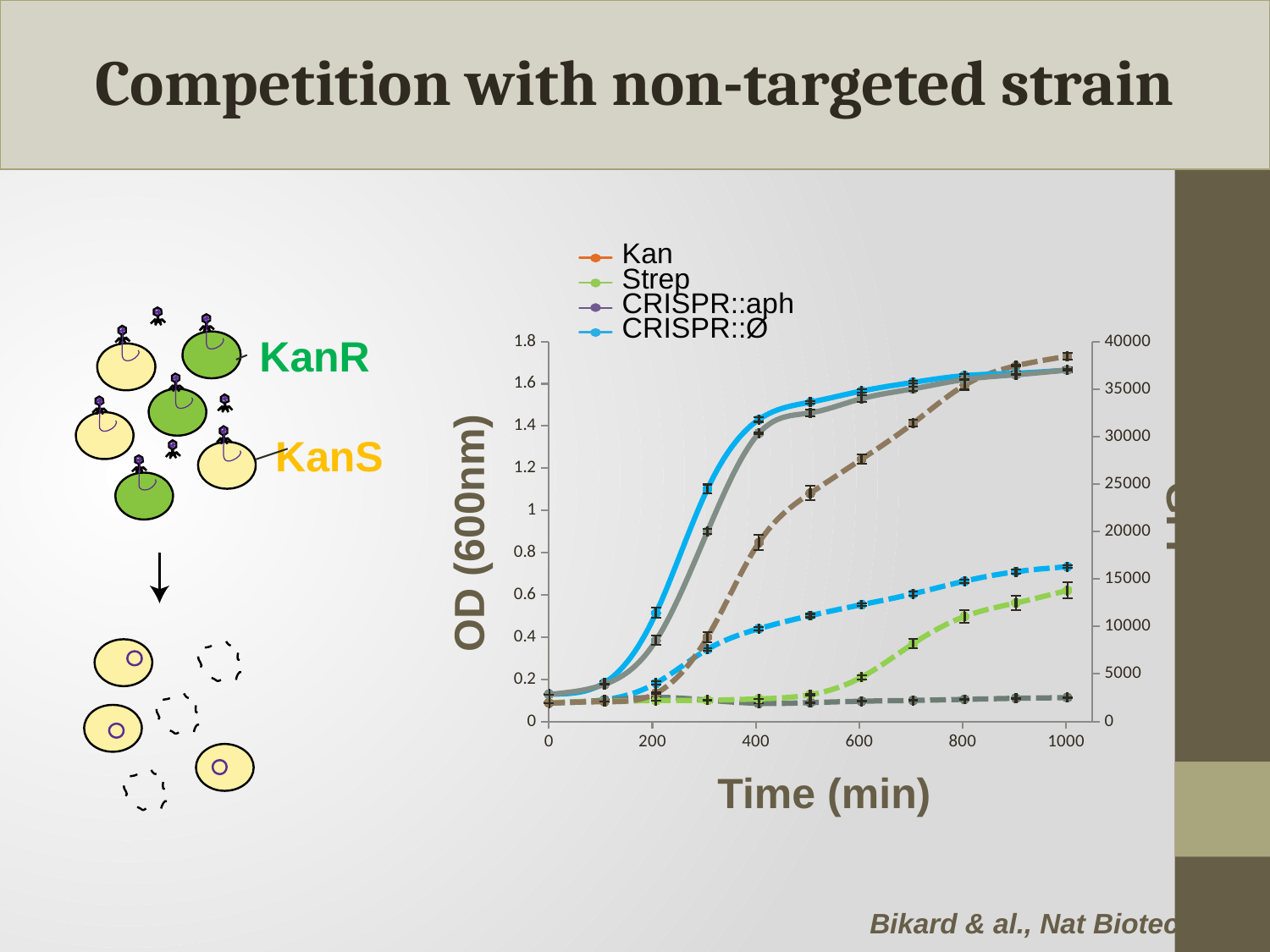
What is the highest tick value shown on the left y axis? 1.8 Is the value of the dashed green line at 1000 min greater or less than 0.4 on the left axis? greater Does the solid blue line rise or fall as time increases from 0 to 1000 min? rise What is the label of the left y axis of the chart? OD (600nm) What kind of chart is shown on the slide? line chart Is the value of the dashed dark gray line at 1000 min greater or less than 0.2 on the left axis? less How many series does the chart legend list? 4 What is the label of the x axis of the chart? Time (min) What is the highest tick value shown on the x axis? 1000 Is the value of the solid blue line at 400 min greater or less than 1.2 on the left axis? greater At 1000 min, which is higher on the left axis: the solid blue line or the dashed green line? the solid blue line What is the highest tick value shown on the right y axis? 40000